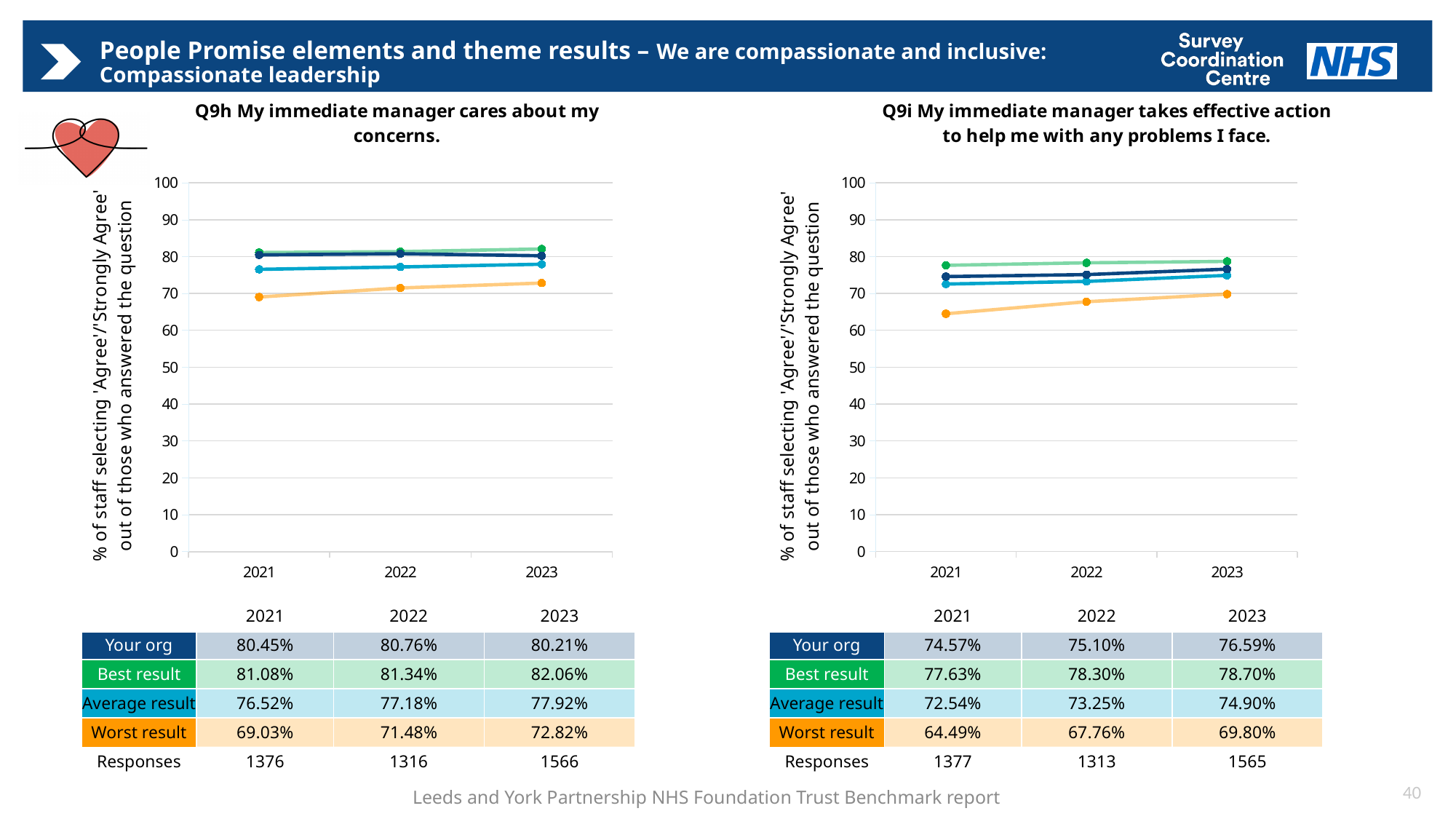
On the Q9i chart, is the 'Worst result' value for 2021 greater or less than 70? less What kind of chart is used for Q9i? Line chart On the Q9i chart, in which year was the 'Your org' value highest? 2023 On the Q9i chart, what was the 'Average result' value in 2023? 74.90% On the Q9i chart, does the 'Your org' value rise or fall from 2021 to 2023? Rise On the Q9h chart, what was the 'Your org' value in 2023? 80.21% On the Q9i chart, what was the 'Worst result' value in 2021? 64.49% On the Q9h chart, what was the 'Best result' value in 2022? 81.34% On the Q9h chart, in which year was the 'Worst result' value lowest? 2021 How many years are shown on the x axis of the Q9h chart? 3 On the Q9i chart, which is larger in 2022: the 'Your org' value or the 'Average result' value? Your org On the Q9h chart, what is the difference between the 'Best result' and 'Your org' values in 2023? 1.85%